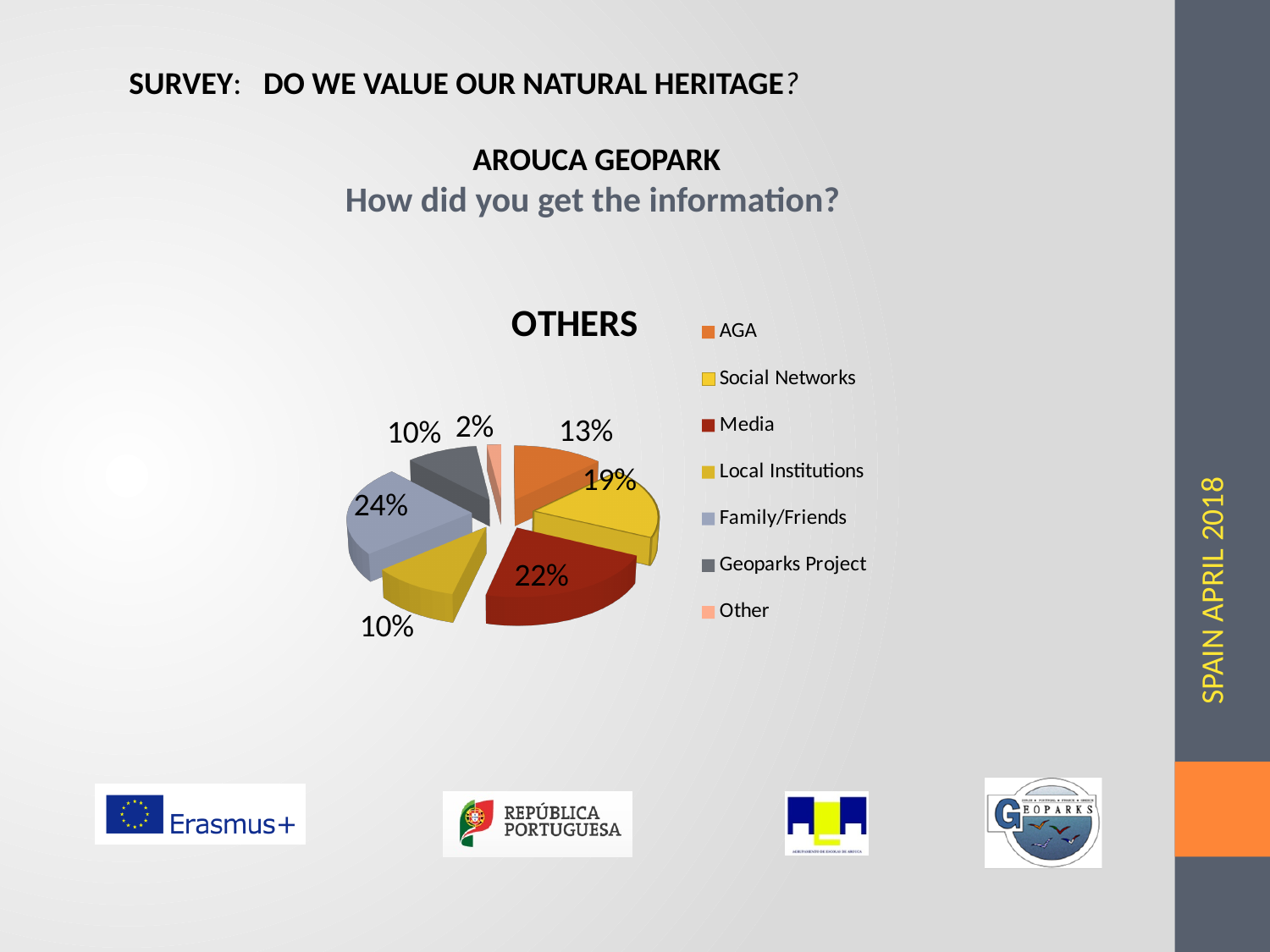
Which has a larger share, Social Networks or AGA? Social Networks What percentage of the pie is Social Networks? 19% How many categories does the legend of the pie chart list? 7 What percentage of the pie is Media? 22% What type of chart is shown on the slide? pie chart Which category has the smallest share of the pie? Other What is the title of the chart? OTHERS What is the difference in percentage points between Family/Friends and Media? 2 What percentage of the pie is Family/Friends? 24% What percentage of the pie is AGA? 13% What percentage of the pie is Other? 2% Which category has the largest share of the pie? Family/Friends